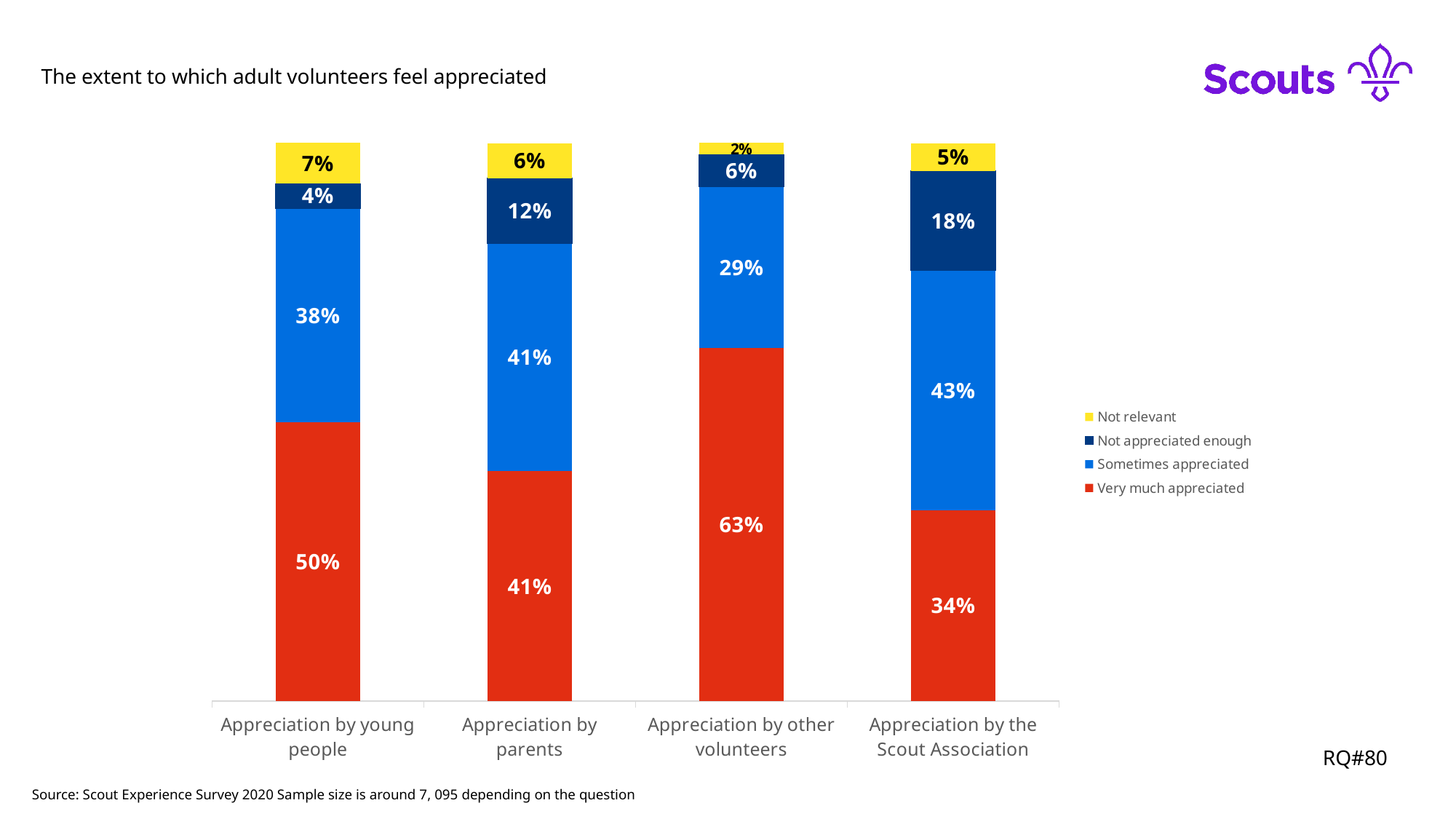
How many categories are shown on the x axis? 4 What percentage of volunteers feel very much appreciated by other volunteers? 63% How many series does the legend list? 4 Which category has the lowest 'Not appreciated enough' value? Appreciation by young people What is the 'Sometimes appreciated' value for Appreciation by parents? 41% What is the title of the chart? The extent to which adult volunteers feel appreciated What is the 'Not relevant' value for Appreciation by young people? 7% What is the difference between the 'Very much appreciated' values for Appreciation by other volunteers and Appreciation by the Scout Association? 29% What is the 'Not appreciated enough' value for Appreciation by the Scout Association? 18% Which is larger: the 'Sometimes appreciated' value for Appreciation by the Scout Association or for Appreciation by young people? Appreciation by the Scout Association What kind of chart is shown on the slide? Stacked bar chart Which category has the highest 'Very much appreciated' value? Appreciation by other volunteers